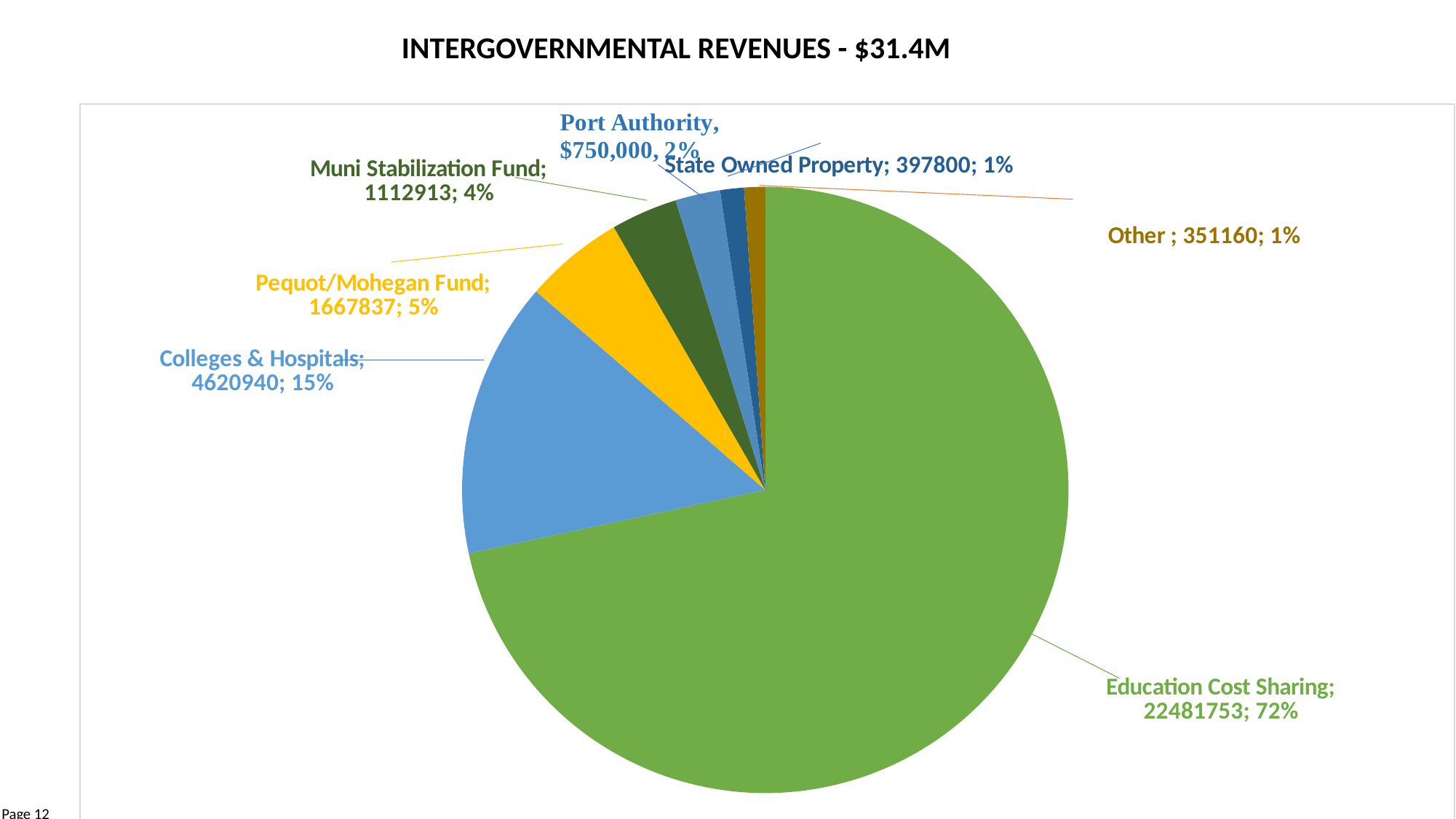
What is the value shown for Colleges & Hospitals? 4620940 What kind of chart is shown on the slide? Pie chart How many slices does the pie chart have? 7 What value is shown for Port Authority? $750,000 Which category has the largest slice of the pie? Education Cost Sharing Which is larger, Colleges & Hospitals or Pequot/Mohegan Fund? Colleges & Hospitals What is the value shown for the Muni Stabilization Fund? 1112913 What share of the pie does Education Cost Sharing represent? 72% What is the difference between the values for State Owned Property and Other? 46640 What is the title of the chart? INTERGOVERNMENTAL REVENUES - $31.4M What percentage is shown for the Pequot/Mohegan Fund slice? 5% What is the value shown for Education Cost Sharing? 22481753